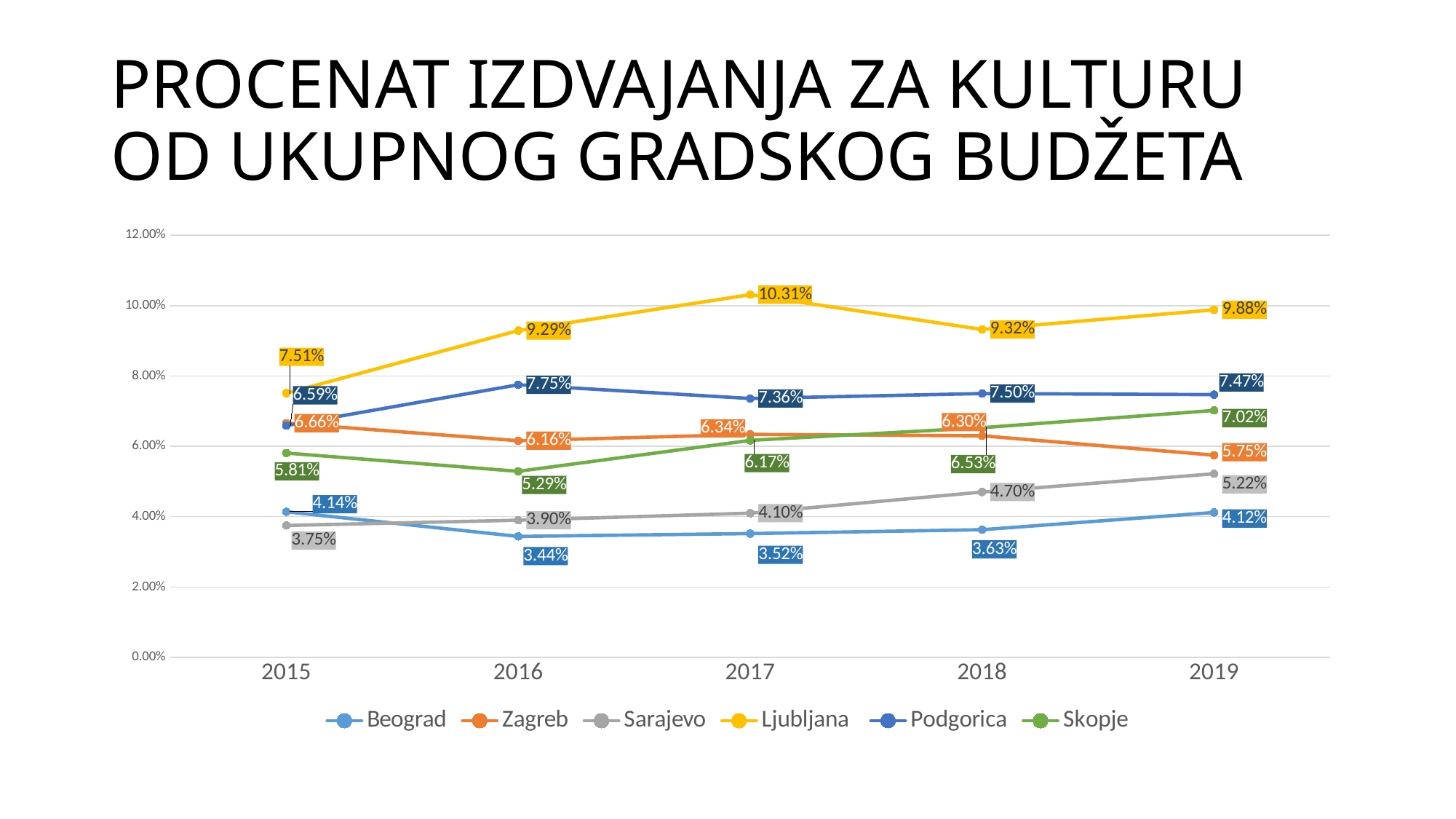
What is the value for Sarajevo in 2019? 5.22% What is the value for Beograd in 2016? 3.44% What is the value for Podgorica in 2018? 7.50% How many series does the legend list? 6 Does the value for Sarajevo rise or fall from 2015 to 2019? Rise What is the difference between Ljubljana's value in 2017 and its value in 2015? 2.80% What is the value for Ljubljana in 2017? 10.31% What kind of chart is shown on the slide? Line chart How many years are shown on the x axis? 5 Which city has the highest value in 2019? Ljubljana Which city has the lowest value in 2017? Beograd Which is larger in 2018, the value for Zagreb or the value for Skopje? Skopje